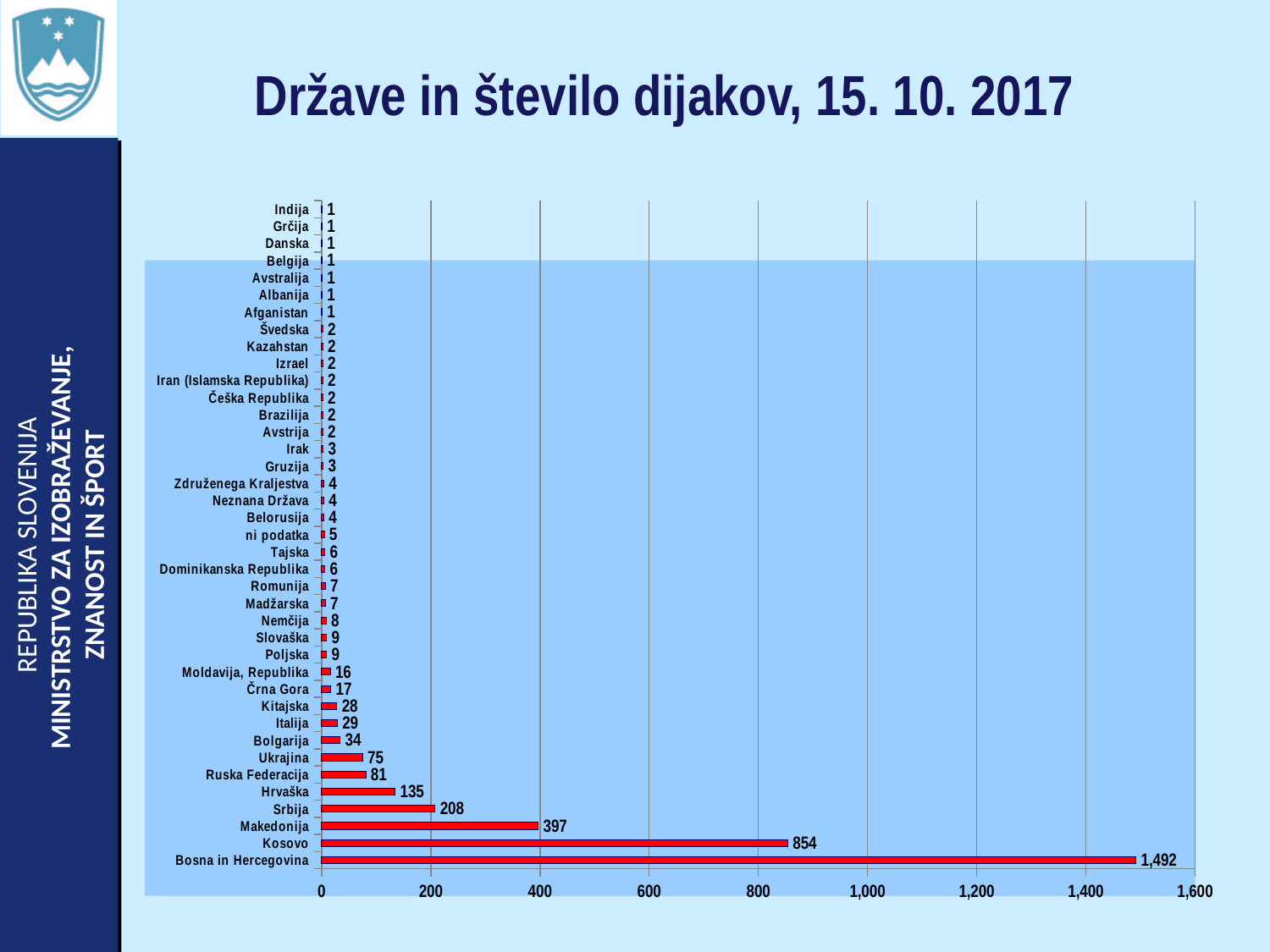
How many categories are shown on the chart? 39 Which country has the highest number of students? Bosna in Hercegovina What is the value for Bosna in Hercegovina? 1,492 What is the value for Hrvaška? 135 Is the value for Kosovo greater or less than 800? greater What is the difference between the values for Makedonija and Srbija? 189 Which is larger, the value for Ruska Federacija or the value for Bolgarija? Ruska Federacija What is the difference between the values for Bosna in Hercegovina and Kosovo? 638 What is the title of the chart? Države in število dijakov, 15. 10. 2017 What kind of chart is shown on the slide? Bar chart What is the value for Ukrajina? 75 What is the value for Kosovo? 854